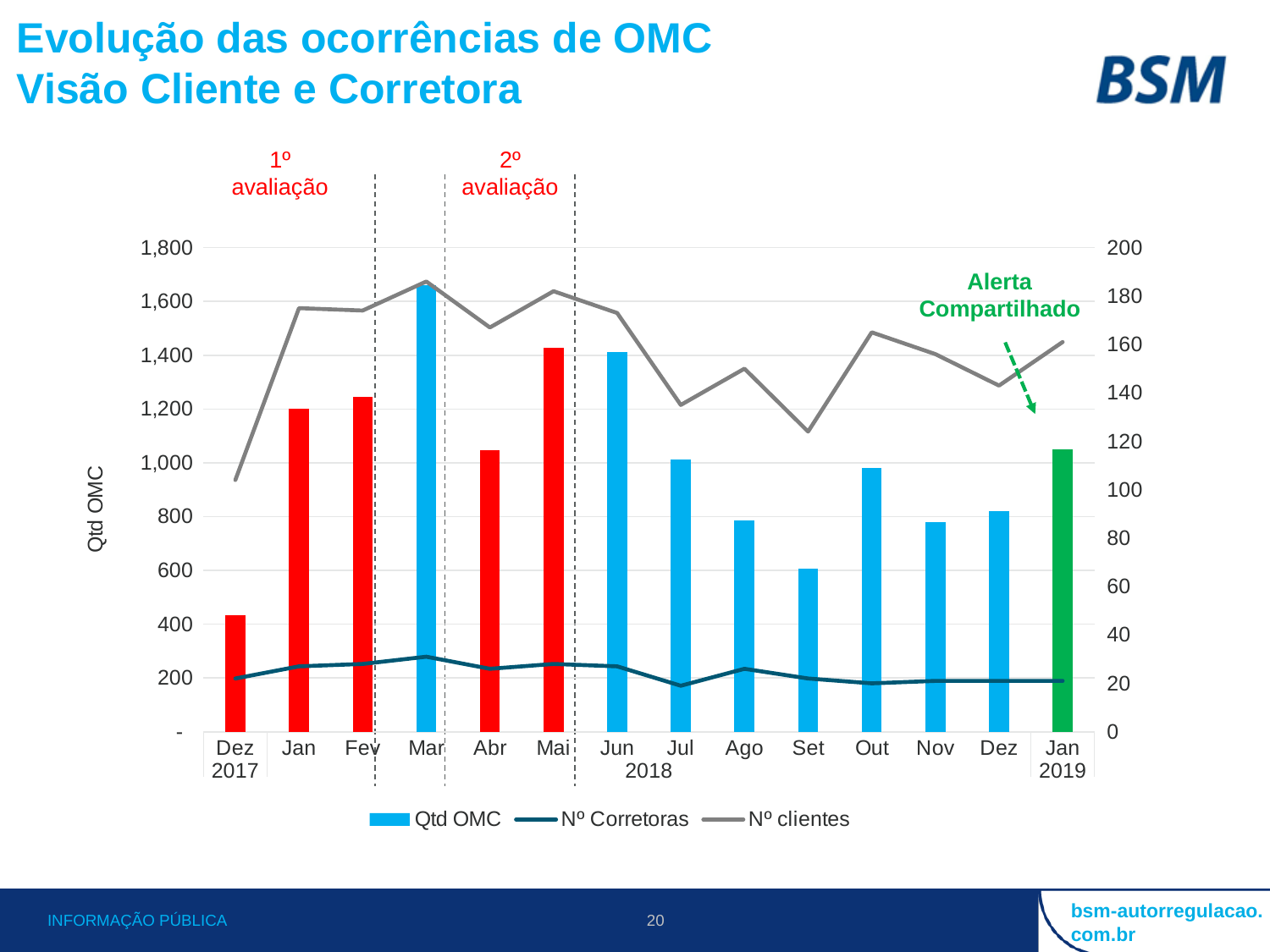
Which month has the lowest Qtd OMC bar? Dez 2017 How many series does the legend list? 3 What kind of chart is shown on the slide? A combined bar and line chart Does the Qtd OMC bar rise or fall from Jun 2018 to Set 2018? Fall Which has the larger Qtd OMC bar, Jan 2018 or Ago 2018? Jan 2018 Is the Qtd OMC value for Set 2018 greater or less than 800? less Is the Qtd OMC value for Dez 2017 greater or less than 600? less What are the three series named in the legend? Qtd OMC, Nº Corretoras, Nº clientes Is the Qtd OMC value for Mar 2018 greater or less than 1,600? greater How many months are shown along the x axis? 14 Which month has the highest Qtd OMC bar? Mar 2018 Does the Nº clientes line rise or fall from Dez 2017 to Jan 2018? Rise